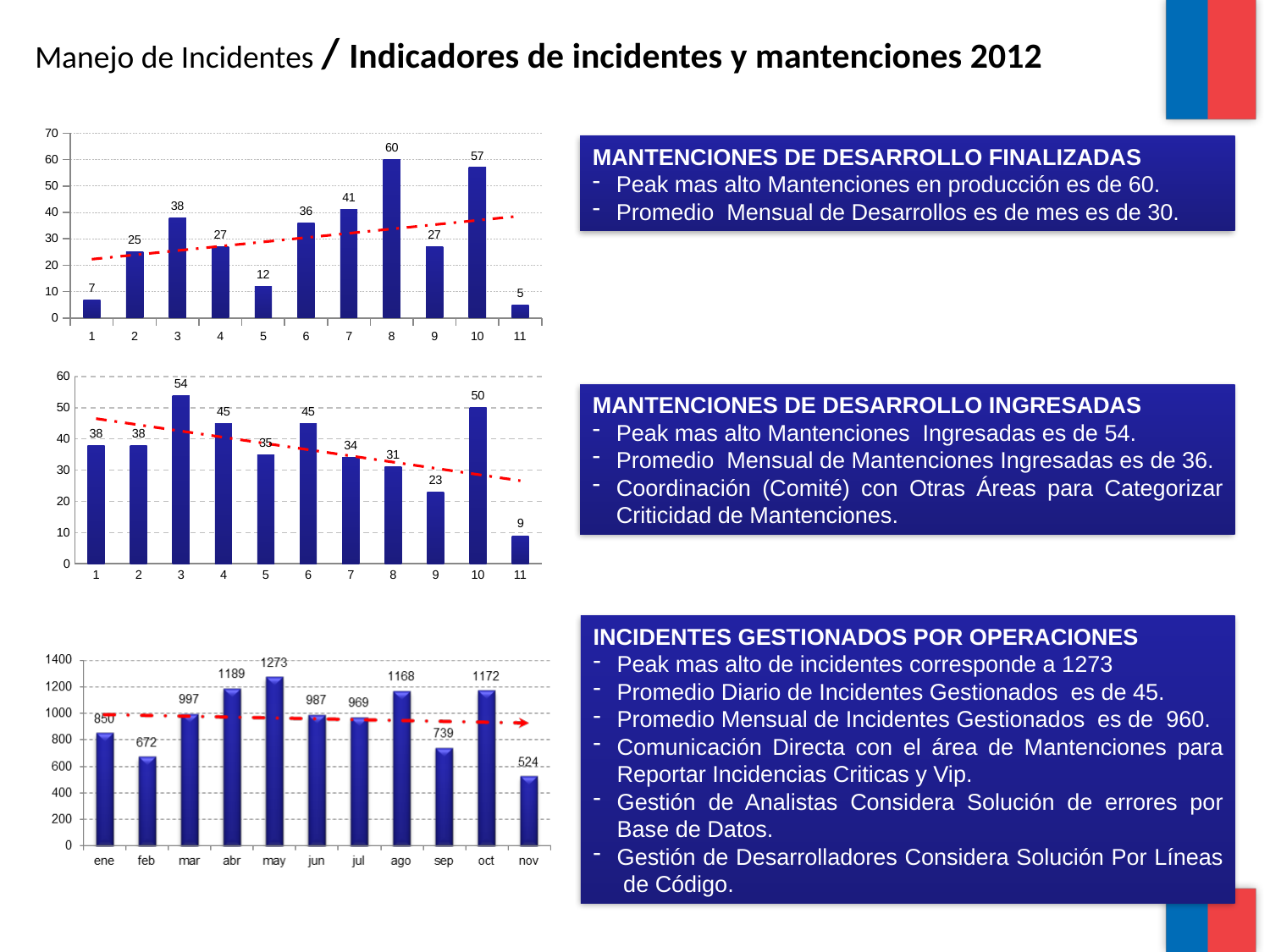
In the top chart, how many bars are plotted? 11 In the middle chart, which category has the lowest value? 11 In the middle chart, which is larger, the value for category 4 or category 5? category 4 In the middle chart, what is the difference between the values for categories 10 and 9? 27 In the top chart, which category has the lowest value? 11 In the middle chart, what is the value for category 3? 54 In the top chart, what is the difference between the values for categories 10 and 9? 30 In the top chart, what is the value for category 8? 60 In the bottom chart, which month has the lowest value? nov In the bottom chart, what is the value for may? 1273 What kind of chart is the bottom chart? bar chart In the bottom chart, what is the difference between the values for abr and feb? 517